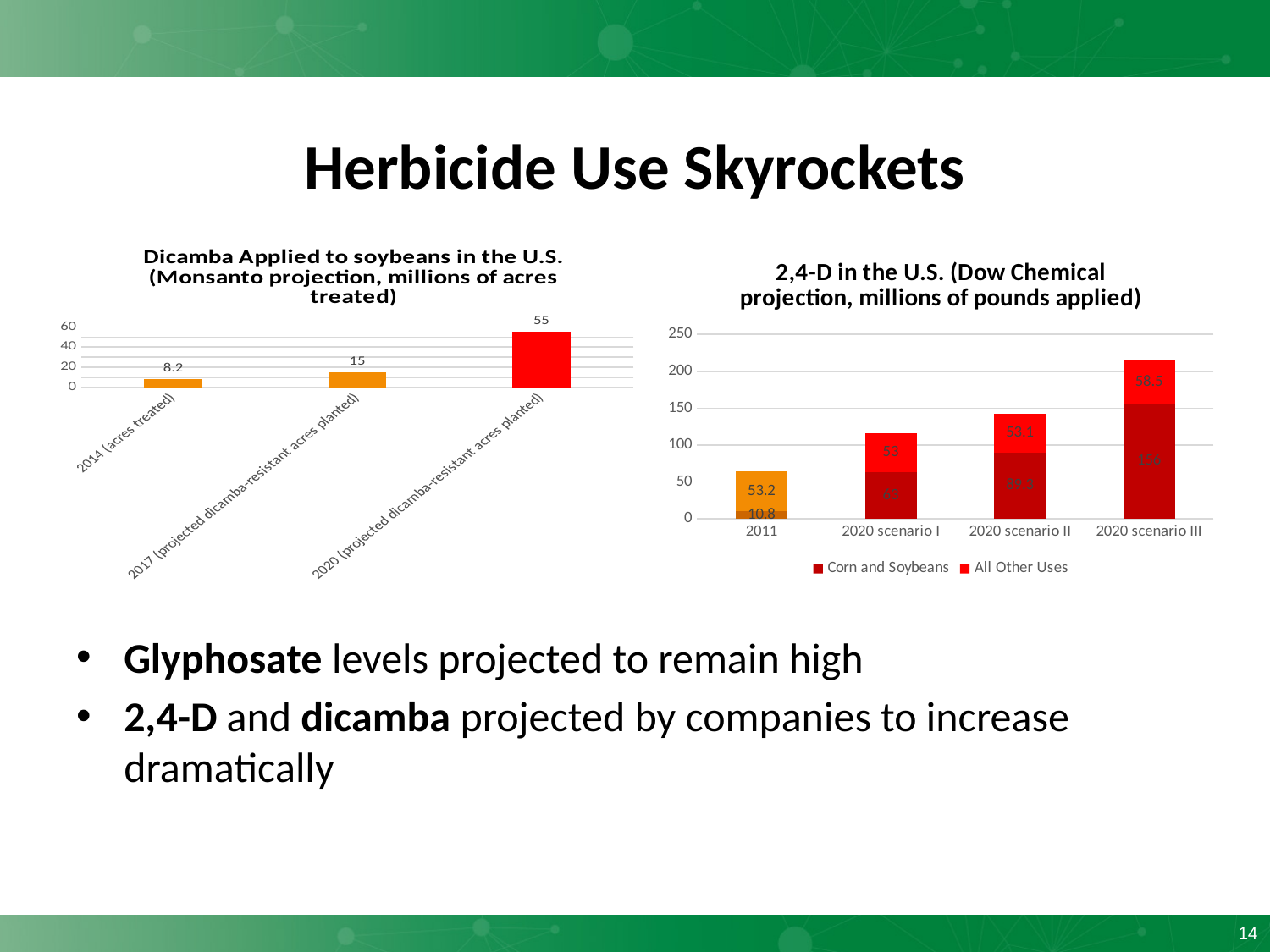
In the 2,4-D in the U.S. chart, what is the All Other Uses value for 2011? 53.2 How many categories are plotted in the Dicamba chart on the left? 3 In the Dicamba chart on the left, what is the difference between the 2020 value and the 2017 value? 40 In the Dicamba chart on the left, what value is shown for 2020 (projected dicamba-resistant acres planted)? 55 In the 2,4-D in the U.S. chart, what is the Corn and Soybeans value for 2011? 10.8 In the Dicamba chart on the left, what value is shown for 2014 (acres treated)? 8.2 In the 2,4-D in the U.S. chart, what is the total of the stacked bar for 2011? 64 What kind of chart is the 2,4-D in the U.S. chart on the right? stacked bar chart How many series does the legend of the 2,4-D in the U.S. chart list? 2 In the 2,4-D in the U.S. chart, is the total for 2020 scenario III greater or less than 200? greater Do the values in the Dicamba chart on the left rise or fall from 2014 to 2020? rise In the Dicamba chart on the left, which category has the highest value? 2020 (projected dicamba-resistant acres planted)